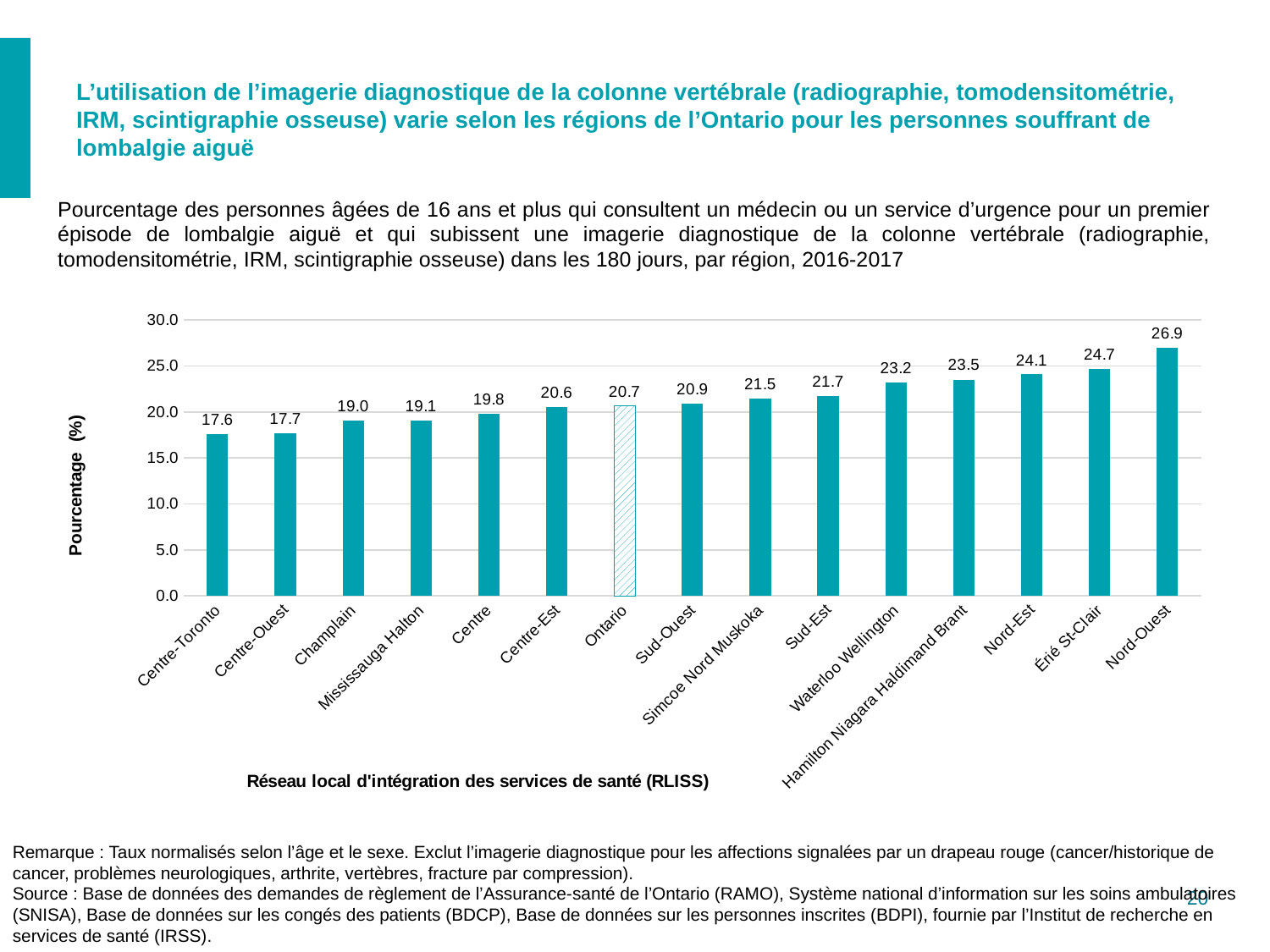
Which region has the highest value? Nord-Ouest What is the value for Ontario? 20.7 How many bars are shown in the chart? 15 What is the label of the x axis? Réseau local d'intégration des services de santé (RLISS) What is the difference between the values for Érié St-Clair and Ontario? 4.0 What is the value for Nord-Ouest? 26.9 What kind of chart is shown on the slide? bar chart Which region has the lowest value? Centre-Toronto What is the value for Mississauga Halton? 19.1 Is the value for Nord-Est greater or less than 20.0? greater Which is larger, the value for Waterloo Wellington or the value for Sud-Est? Waterloo Wellington What is the difference between the values for Nord-Ouest and Centre-Toronto? 9.3